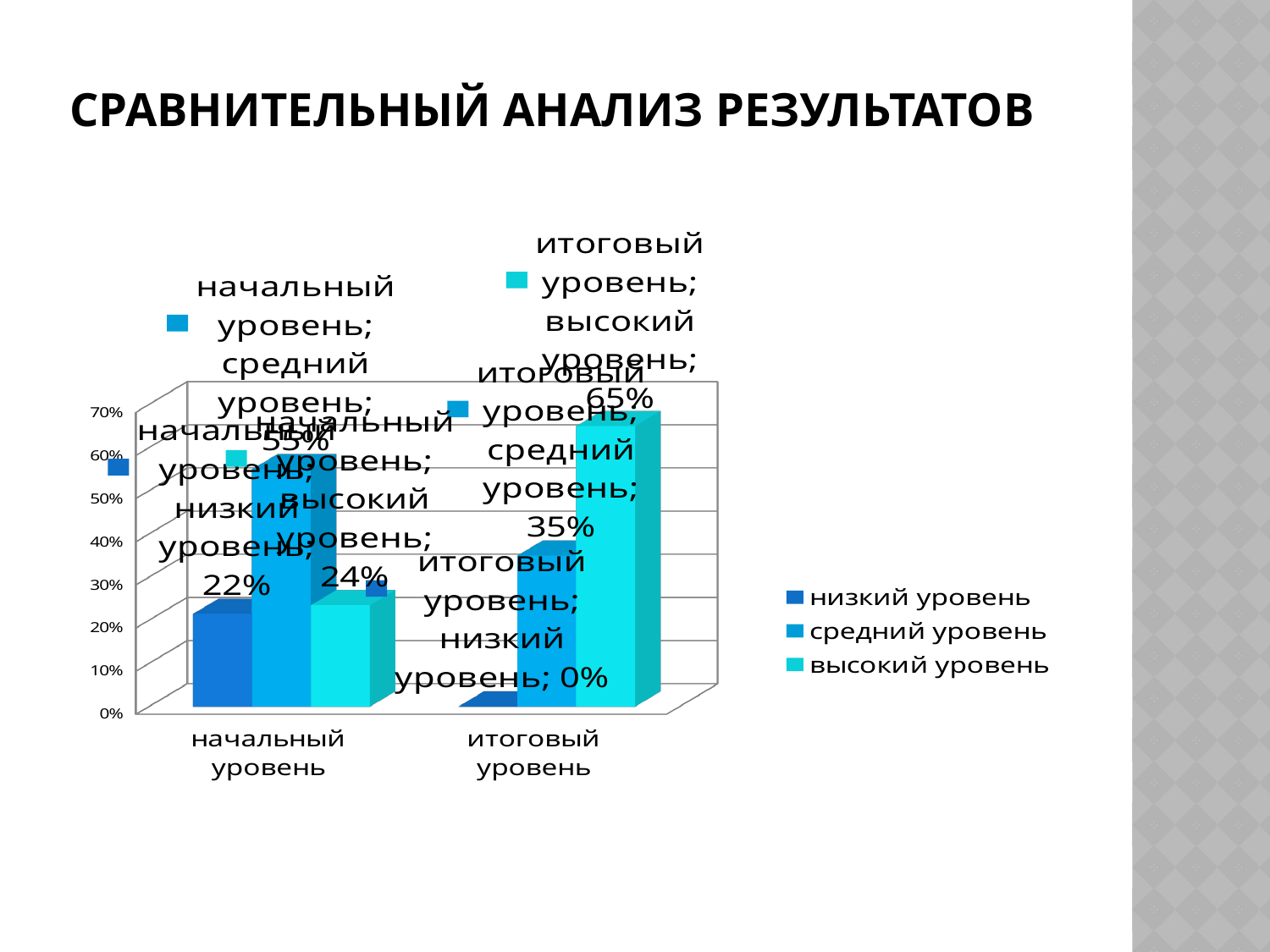
What is the value for низкий уровень at начальный уровень? 22% What is the value for низкий уровень at итоговый уровень? 0% What kind of chart is shown on the slide? bar chart How many categories are shown on the x axis? 2 Which series has the lowest value at начальный уровень? низкий уровень What is the value for высокий уровень at итоговый уровень? 65% Which is larger: средний уровень at начальный уровень or средний уровень at итоговый уровень? средний уровень at начальный уровень What is the value for средний уровень at начальный уровень? 55% What is the difference between высокий уровень at итоговый уровень and высокий уровень at начальный уровень? 41% Which series has the highest value at итоговый уровень? высокий уровень What is the value for средний уровень at итоговый уровень? 35% How many series does the legend list? 3